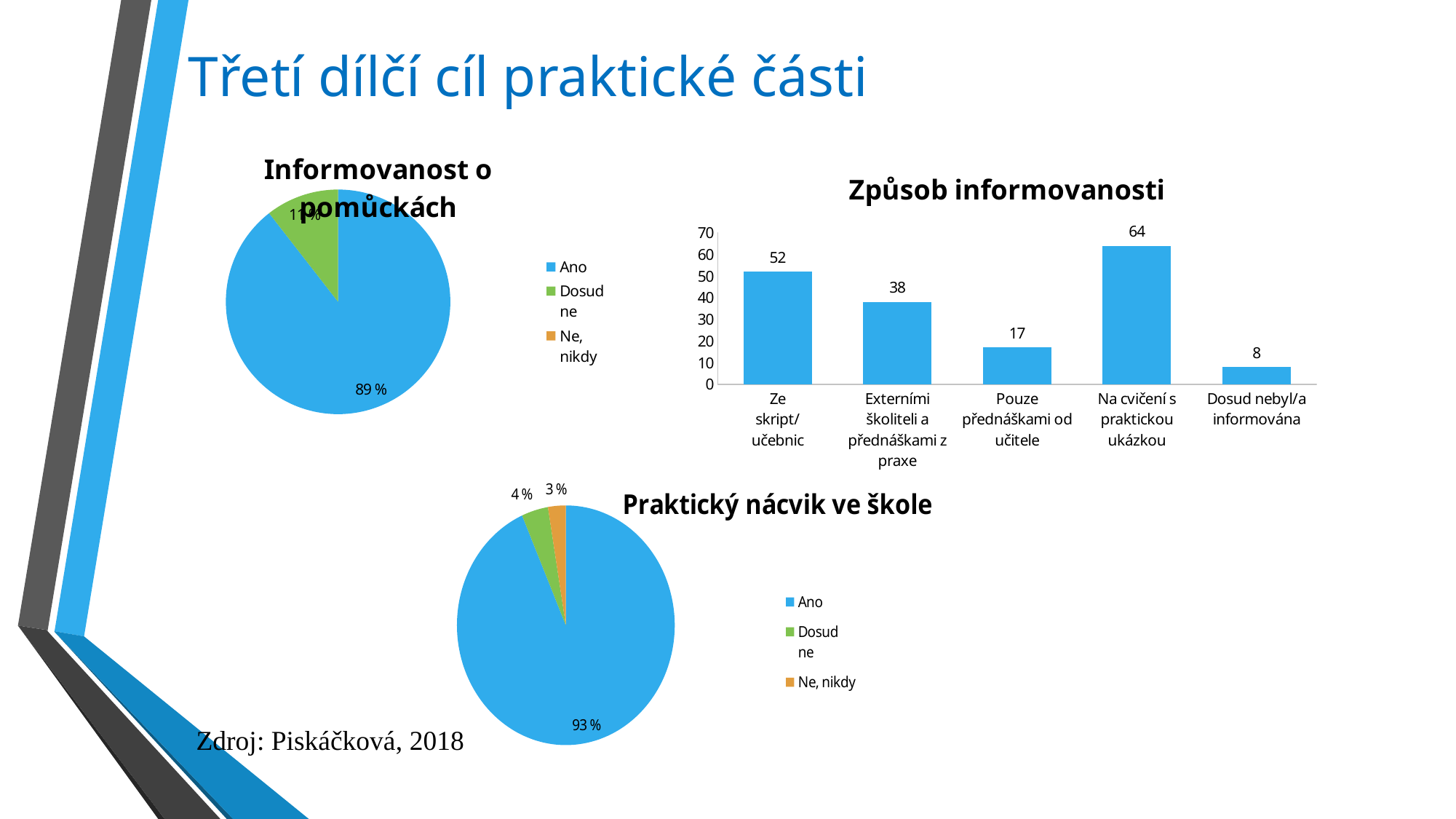
How many categories are shown in the 'Způsob informovanosti' chart? 5 In the 'Způsob informovanosti' chart, which category has the lowest value? Dosud nebyl/a informována How many entries does the legend of the 'Praktický nácvik ve škole' pie chart list? 3 What kind of chart is 'Způsob informovanosti'? Bar chart In the 'Praktický nácvik ve škole' pie chart, what share does 'Ne, nikdy' have? 3 % In the 'Způsob informovanosti' chart, what is the value for 'Ze skript/učebnic'? 52 In the 'Způsob informovanosti' chart, what is the difference between 'Na cvičení s praktickou ukázkou' and 'Pouze přednáškami od učitele'? 47 In the 'Způsob informovanosti' chart, what is the value for 'Na cvičení s praktickou ukázkou'? 64 In the 'Praktický nácvik ve škole' pie chart, what share does 'Ano' have? 93 % In the 'Způsob informovanosti' chart, which category has the highest value? Na cvičení s praktickou ukázkou In the 'Způsob informovanosti' chart, which is larger: 'Externími školiteli a přednáškami z praxe' or 'Ze skript/učebnic'? Ze skript/učebnic In the 'Informovanost o pomůckách' pie chart, what share does 'Ano' have? 89 %